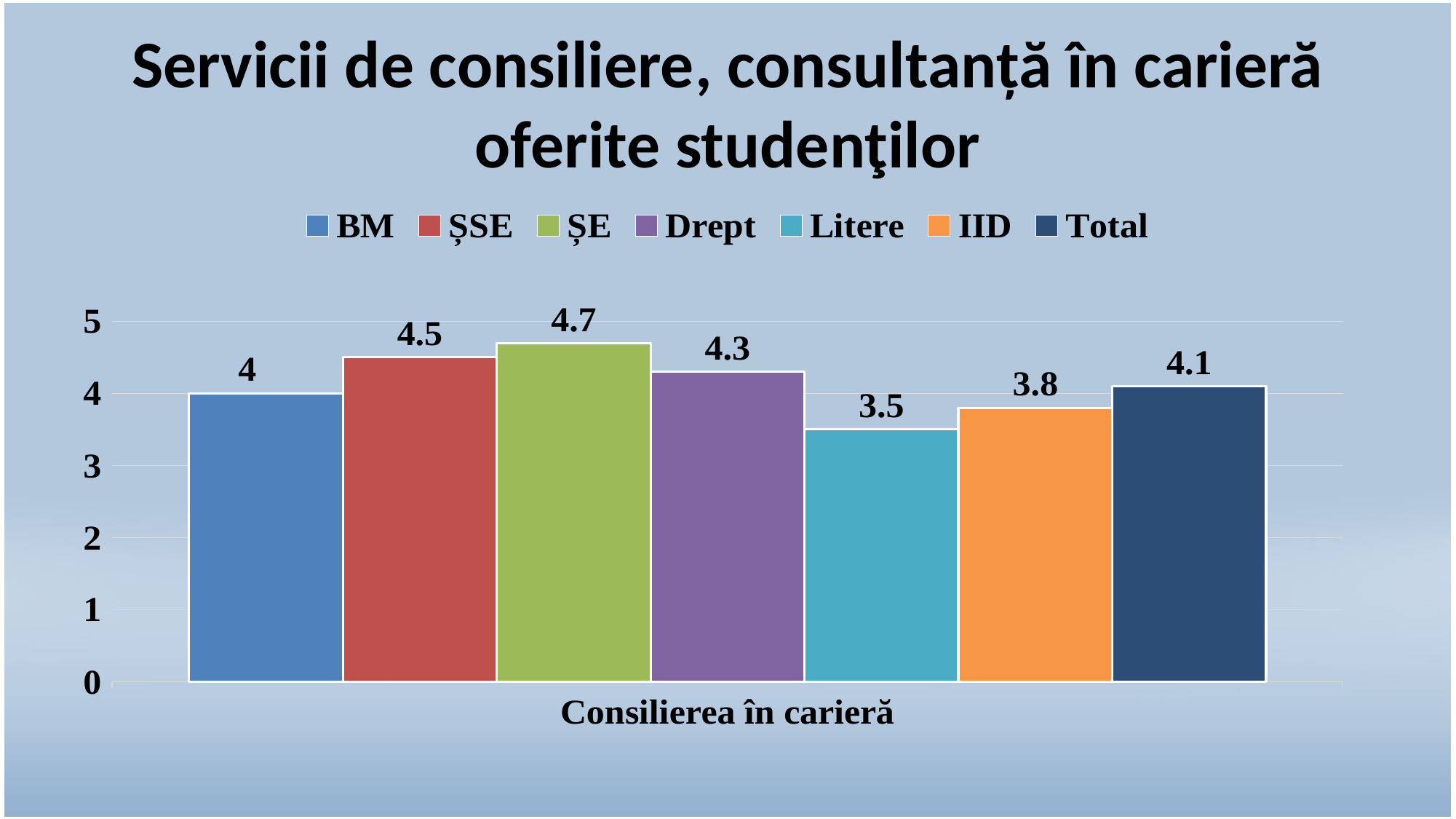
What kind of chart is shown on the slide? bar chart How many series does the legend list? 7 What is the difference between the values for ȘSE and IID? 0.7 Which is larger, the value for Drept or the value for IID? Drept Is the value for Litere greater or less than 4? less Which series has the lowest value? Litere What is the value for BM? 4 What is the value for ȘE? 4.7 What is the label on the x axis of the chart? Consilierea în carieră Which series has the highest value? ȘE What is the value for Total? 4.1 What is the value for Litere? 3.5